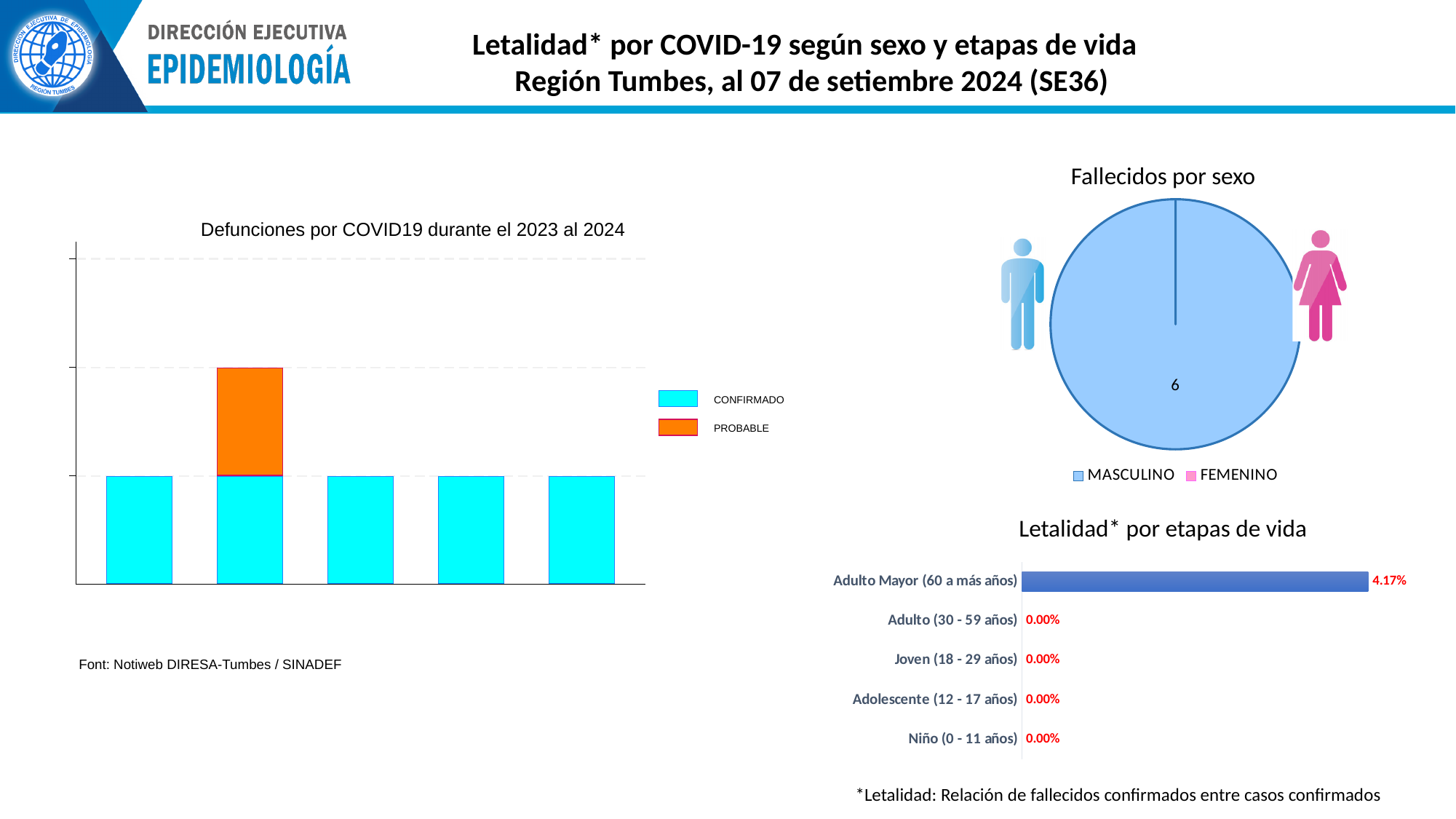
What kind of chart is 'Letalidad* por etapas de vida'? Bar chart In the 'Fallecidos por sexo' chart, what is the value shown for MASCULINO? 6 What kind of chart is 'Defunciones por COVID19 durante el 2023 al 2024'? Bar chart In the 'Letalidad* por etapas de vida' chart, which age group has the highest value? Adulto Mayor (60 a más años) What kind of chart is 'Fallecidos por sexo'? Pie chart How many age groups are shown in the 'Letalidad* por etapas de vida' chart? 5 In the 'Letalidad* por etapas de vida' chart, which is larger: the value for Adulto Mayor (60 a más años) or Niño (0 - 11 años)? Adulto Mayor (60 a más años) In the 'Letalidad* por etapas de vida' chart, what is the value for Adulto Mayor (60 a más años)? 4.17% In the 'Letalidad* por etapas de vida' chart, what is the value for Joven (18 - 29 años)? 0.00% In the 'Letalidad* por etapas de vida' chart, what is the difference between the values for Adulto Mayor (60 a más años) and Adulto (30 - 59 años)? 4.17% How many series does the legend of the 'Defunciones por COVID19 durante el 2023 al 2024' chart list? 2 How many entries does the legend of the 'Fallecidos por sexo' chart list? 2